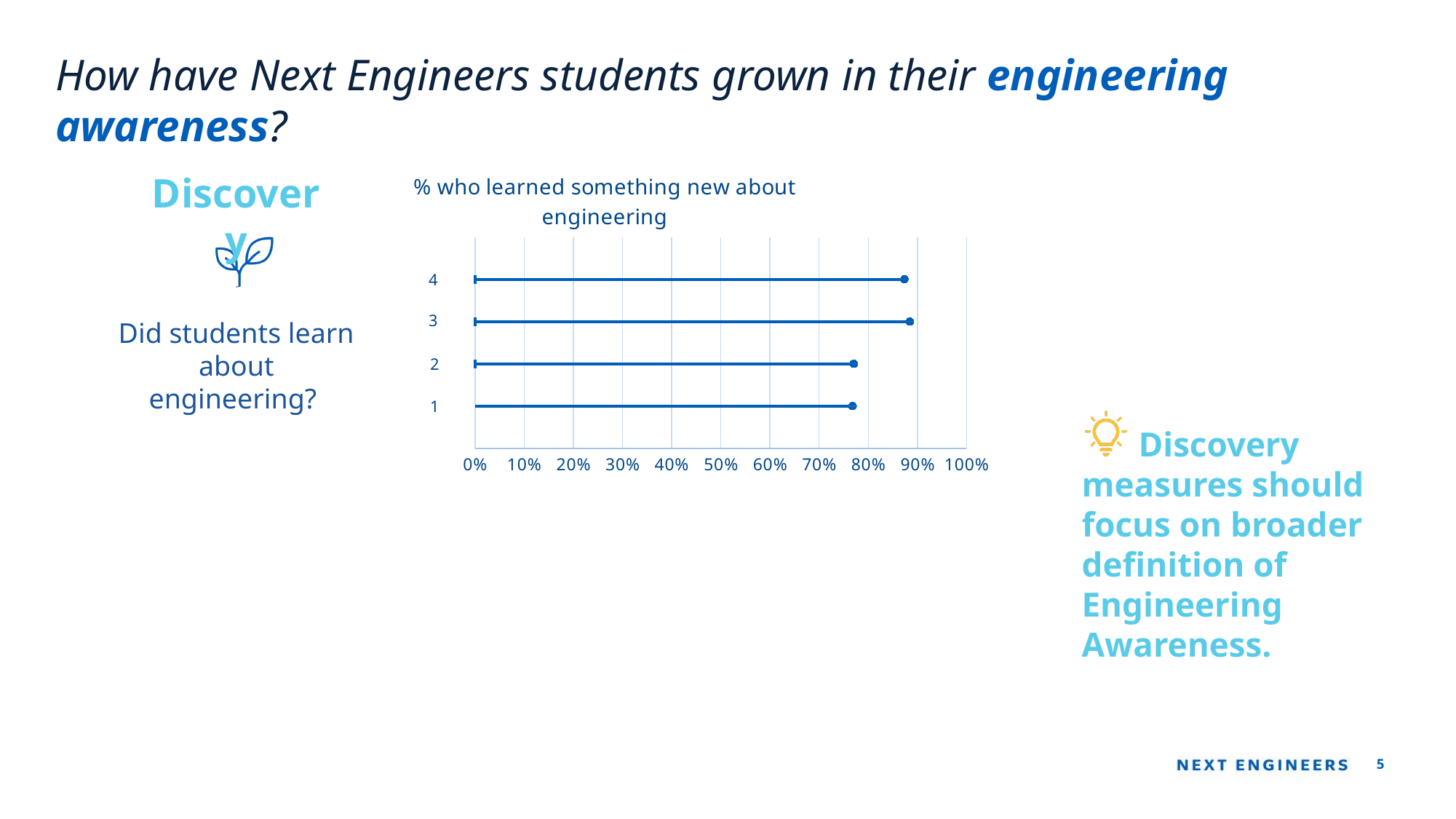
Is the value for category 1 greater or less than 70%? greater Which has the larger value, category 3 or category 2? category 3 What is the highest value shown on the x axis of the chart? 100% Is the value for category 3 greater or less than 80%? greater Is the value for category 4 greater or less than 80%? greater What kind of chart is shown on the slide? dot plot (scatter chart with horizontal lines to each point) What is the title of the chart? % who learned something new about engineering Which has the larger value, category 1 or category 4? category 4 How many categories are plotted on the chart? 4